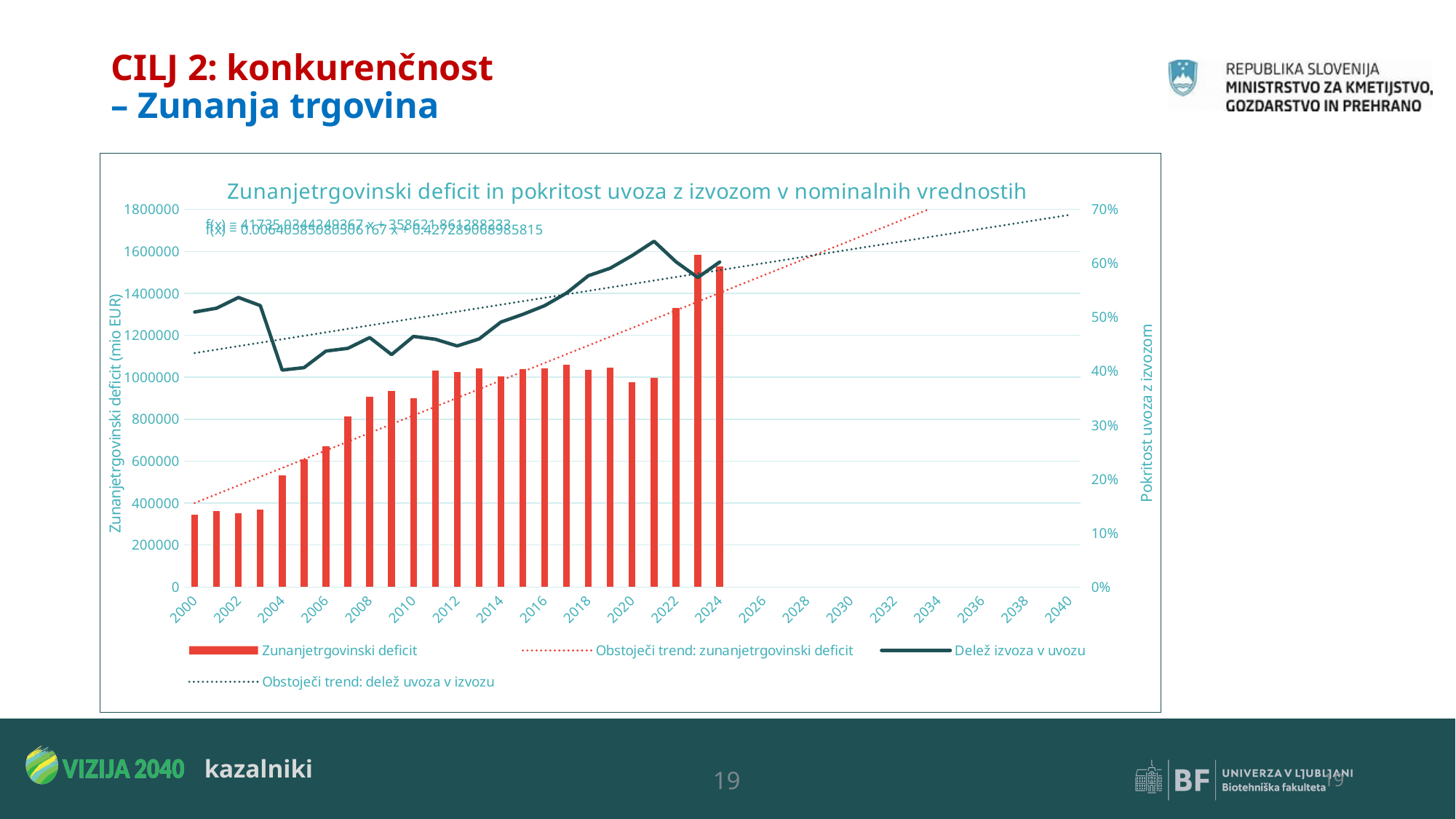
Is the Zunanjetrgovinski deficit bar for 2023 greater or less than 1400000? greater Is the Delež izvoza v uvozu value for 2003 greater or less than 50%? greater Do the Zunanjetrgovinski deficit bars generally rise or fall from 2000 to 2024? Rise Which year has the larger Zunanjetrgovinski deficit bar, 2021 or 2022? 2022 What kind of chart is shown on the slide? A combined bar and line chart What is the title of the chart? Zunanjetrgovinski deficit in pokritost uvoza z izvozom v nominalnih vrednostih In which year does the Delež izvoza v uvozu line reach its highest point? 2021 Is the Delež izvoza v uvozu value for 2021 greater or less than 60%? greater What is the last year for which a Zunanjetrgovinski deficit bar is plotted? 2024 Which year has the highest bar for Zunanjetrgovinski deficit? 2023 How many series does the legend list? 4